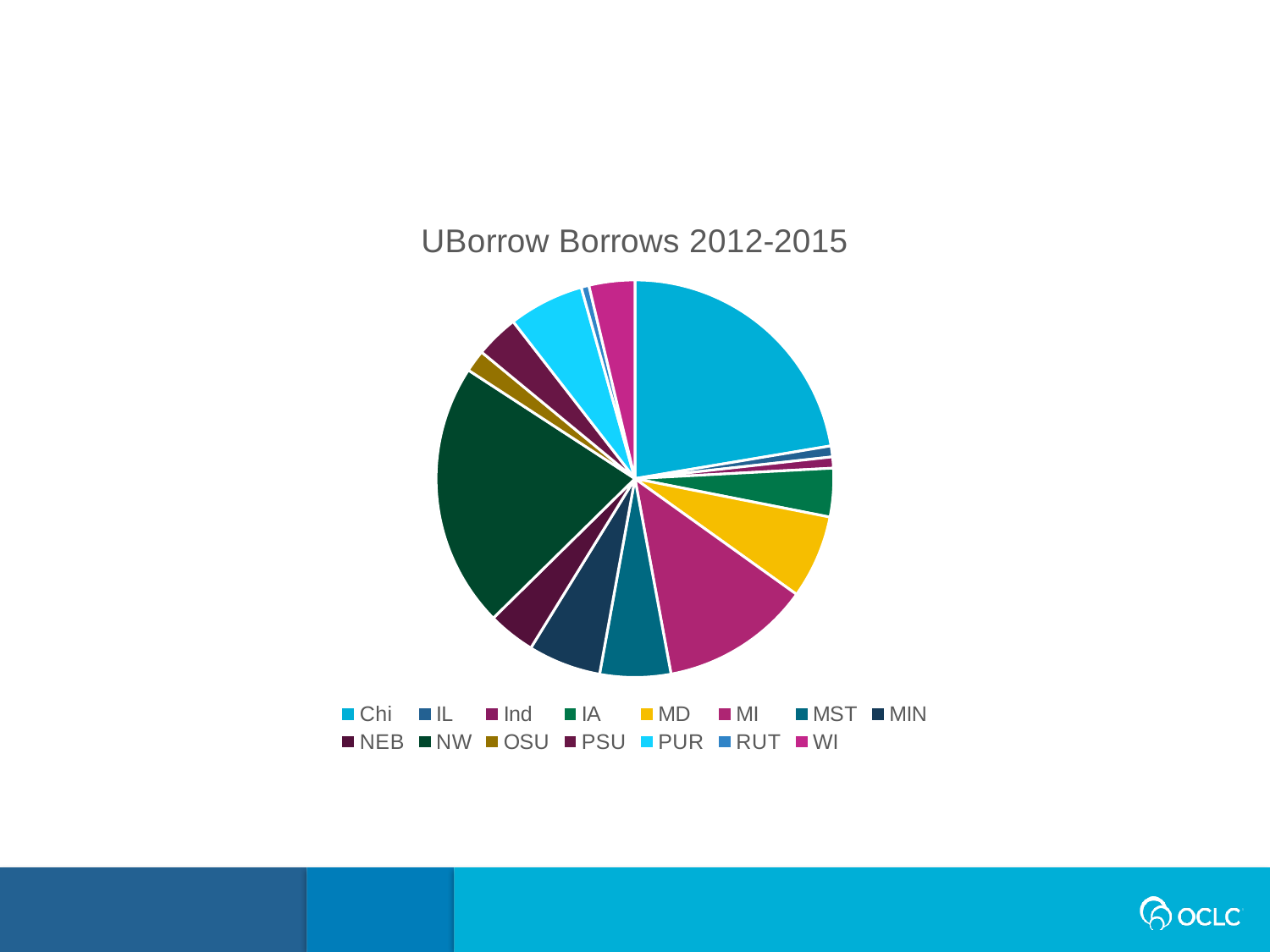
Which slice is larger, MI or Ind? MI What is the title of the chart? UBorrow Borrows 2012-2015 Which slice is larger, Chi or MD? Chi How many categories does the legend of the pie chart list? 15 Which slice is larger, MD or RUT? MD What colour is the MD slice in the pie chart? yellow What kind of chart is shown on the slide? pie chart